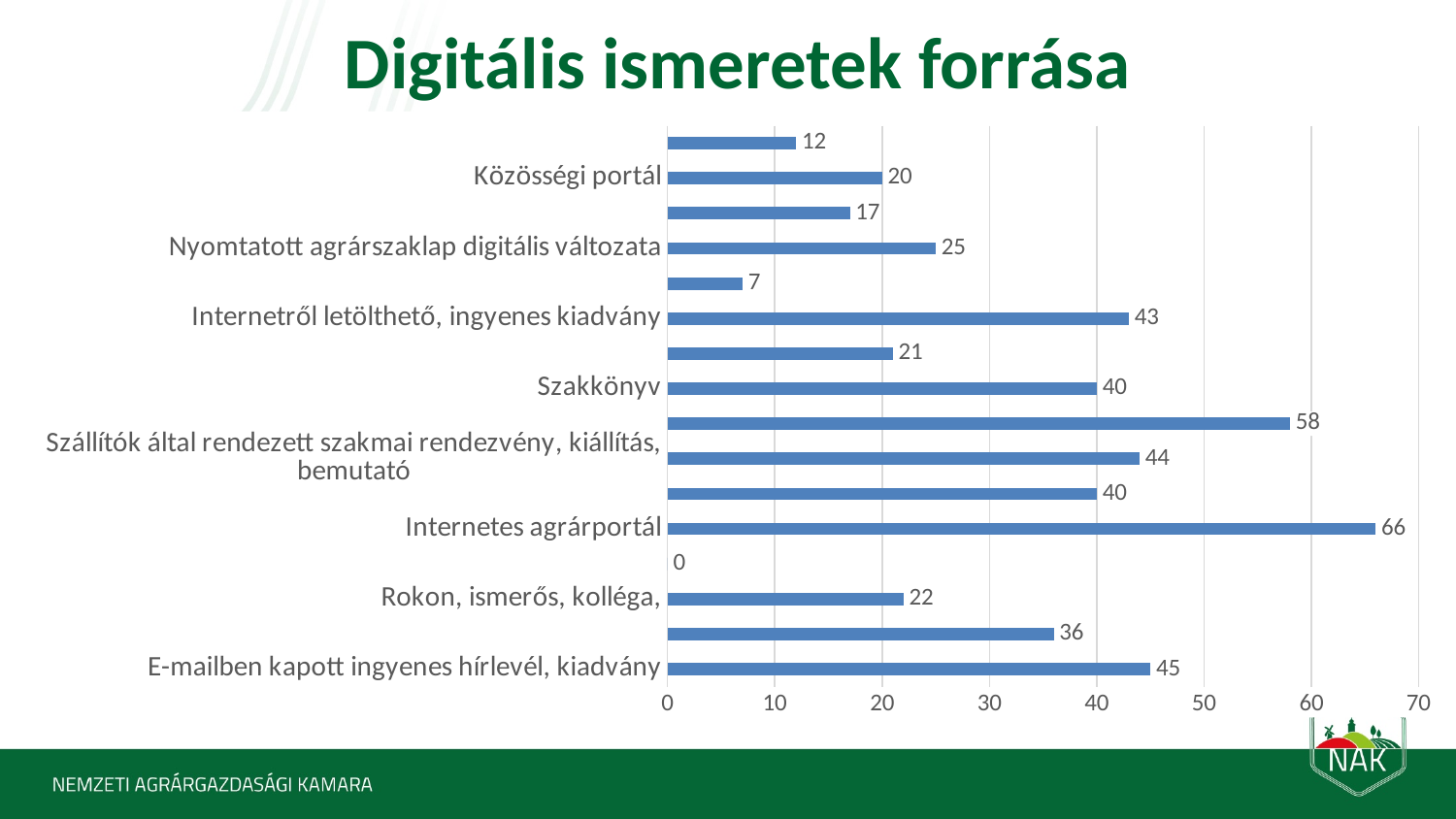
Which labelled category has the highest value? Internetes agrárportál What is the value for Szakkönyv? 40 What is the difference between the values for Internetes agrárportál and E-mailben kapott ingyenes hírlevél, kiadvány? 21 What is the value for Rokon, ismerős, kolléga? 22 How many bars are plotted in the chart? 16 What is the value for E-mailben kapott ingyenes hírlevél, kiadvány? 45 Which is larger, the value for Internetről letölthető, ingyenes kiadvány or the value for Nyomtatott agrárszaklap digitális változata? Internetről letölthető, ingyenes kiadvány What is the value for Közösségi portál? 20 Which labelled category has the lowest value? Közösségi portál What is the title of the slide? Digitális ismeretek forrása What kind of chart is shown on the slide? bar chart What is the value for Internetes agrárportál? 66